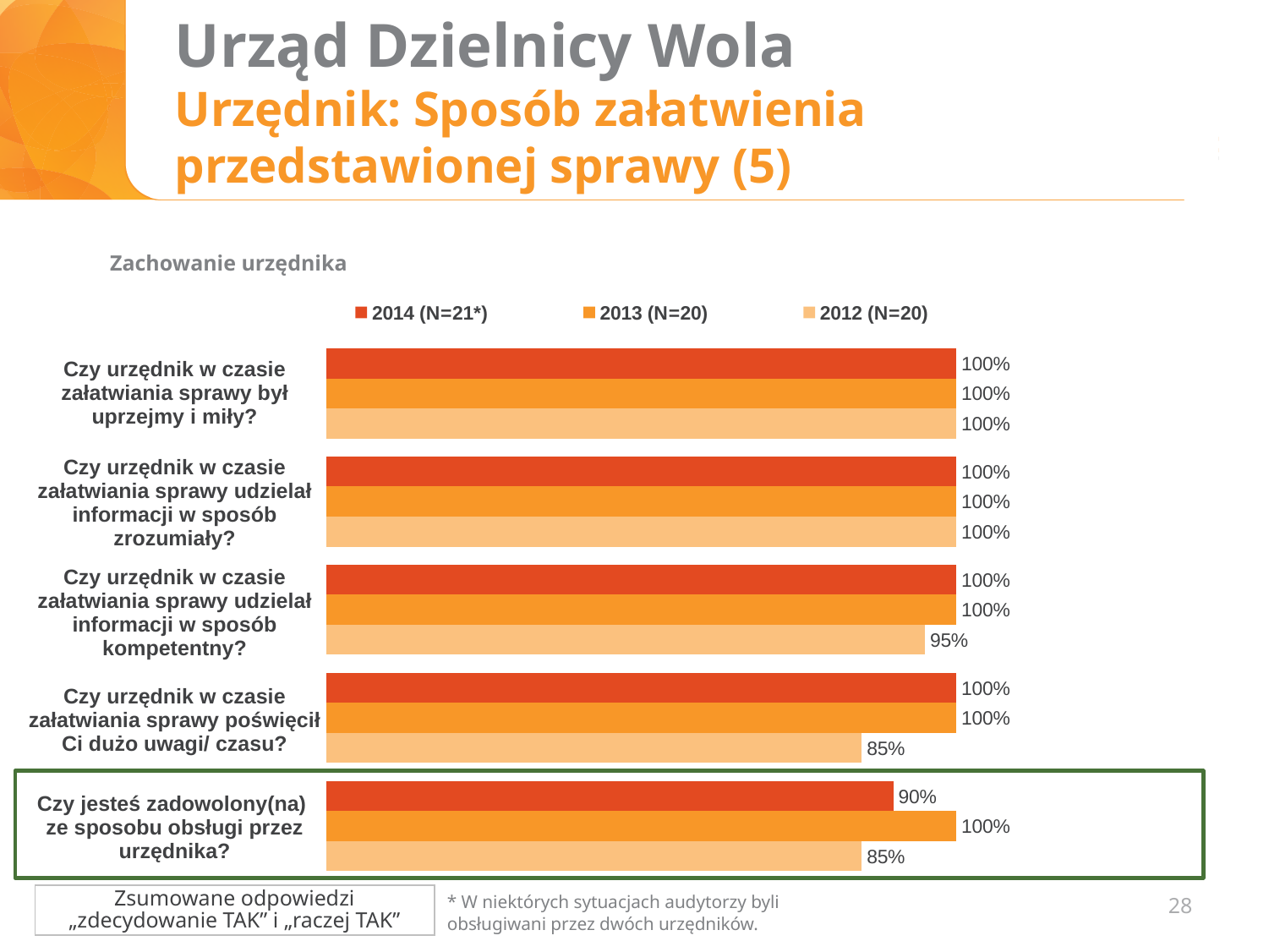
How many question categories are plotted in the chart? 5 What is the 2014 (N=21*) value for "Czy jesteś zadowolony(na) ze sposobu obsługi przez urzędnika?"? 90% What is the difference between the 2013 and 2014 values for "Czy jesteś zadowolony(na) ze sposobu obsługi przez urzędnika?"? 10% What is the 2013 (N=20) value for "Czy jesteś zadowolony(na) ze sposobu obsługi przez urzędnika?"? 100% What is the difference between the 2013 and 2012 values for "Czy urzędnik w czasie załatwiania sprawy poświęcił Ci dużo uwagi/ czasu?"? 15% How many series does the legend list? 3 What kind of chart is shown on the slide? bar chart What is the 2012 (N=20) value for "Czy urzędnik w czasie załatwiania sprawy udzielał informacji w sposób kompetentny?"? 95% What is the 2012 (N=20) value for "Czy urzędnik w czasie załatwiania sprawy poświęcił Ci dużo uwagi/ czasu?"? 85% Which year has the lowest value for "Czy jesteś zadowolony(na) ze sposobu obsługi przez urzędnika?"? 2012 (N=20) What is the subtitle shown above the chart? Zachowanie urzędnika For "Czy jesteś zadowolony(na) ze sposobu obsługi przez urzędnika?", which is larger: the 2014 value or the 2012 value? 2014 (N=21*)